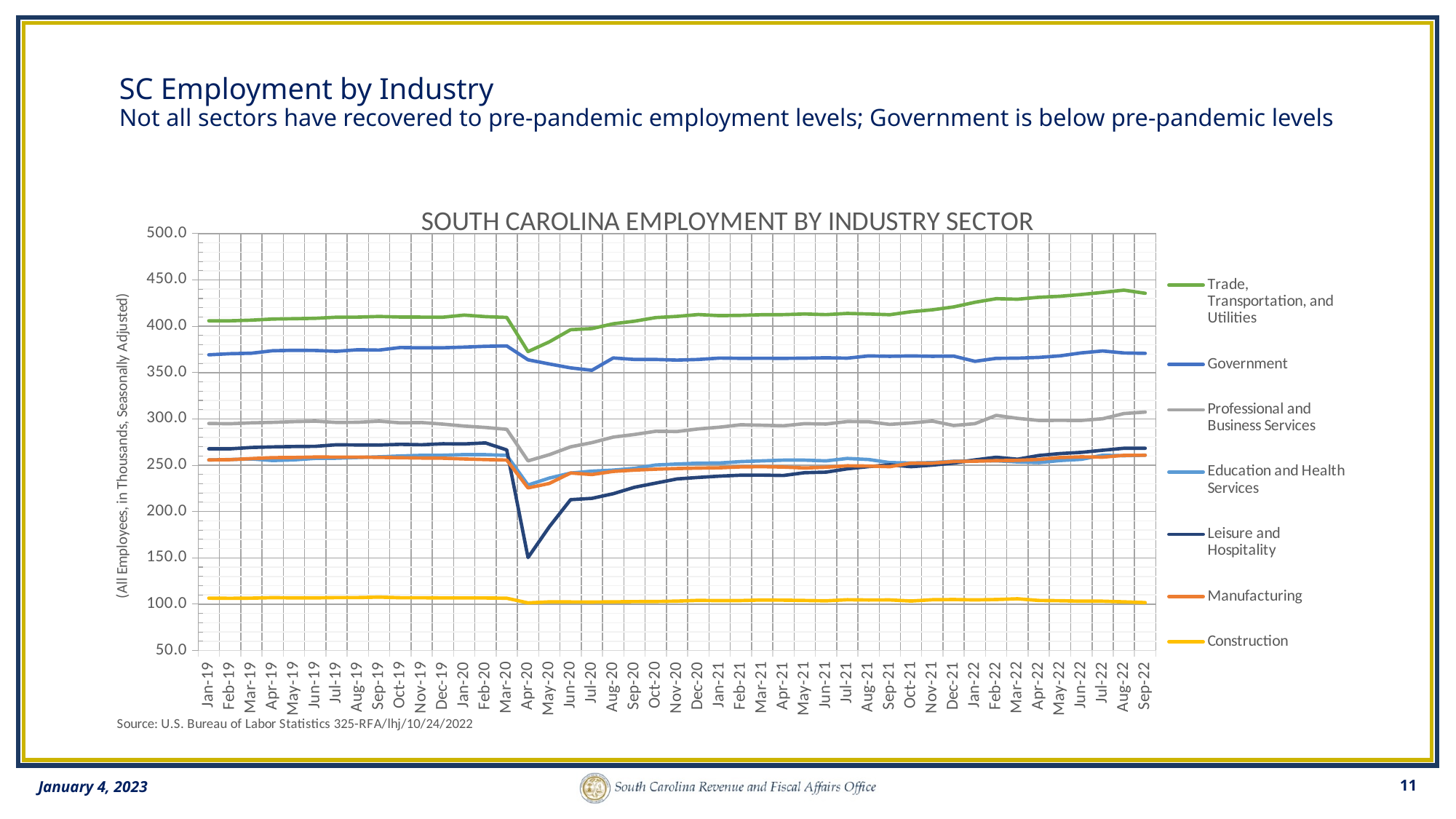
What kind of chart is shown on the slide? line chart Which industry sector has the highest employment across the whole period? Trade, Transportation, and Utilities In Jan-19, which is larger: Government or Professional and Business Services? Government Is the value for Government in Jan-19 greater or less than 350.0? greater Is the value for Trade, Transportation, and Utilities in Sep-22 greater or less than 400.0? greater How many series does the legend list? 7 Is the value for Construction in Jan-19 greater or less than 150.0? less Which industry sector has the lowest employment across the whole period? Construction What is the title of the chart? SOUTH CAROLINA EMPLOYMENT BY INDUSTRY SECTOR Does the Leisure and Hospitality line rise or fall from Apr-20 to Sep-22? rise In Apr-20, which is larger: Manufacturing or Leisure and Hospitality? Manufacturing